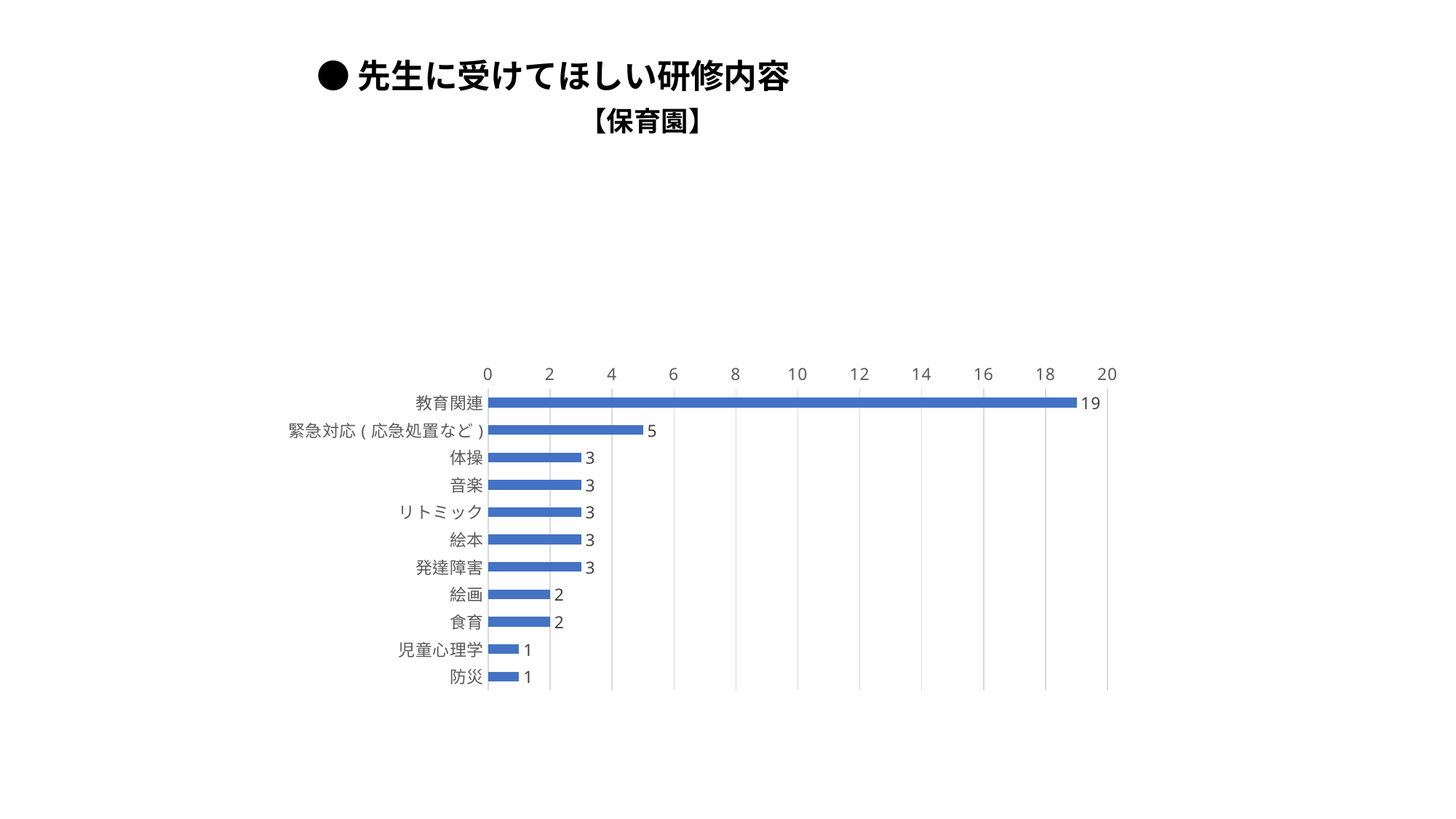
Which is larger, the value for 体操 or the value for 絵画? 体操 What is the maximum value shown on the horizontal axis? 20 How many categories are shown in the chart? 11 Which category has the highest value? 教育関連 Is the value for 教育関連 greater or less than 10? greater What kind of chart is shown on the slide? bar chart What is the value for 食育? 2 What is the value for 教育関連? 19 What is the difference between the values for 教育関連 and 緊急対応(応急処置など)? 14 What is the difference between the values for 発達障害 and 児童心理学? 2 What is the value for 防災? 1 What is the value for 緊急対応(応急処置など)? 5